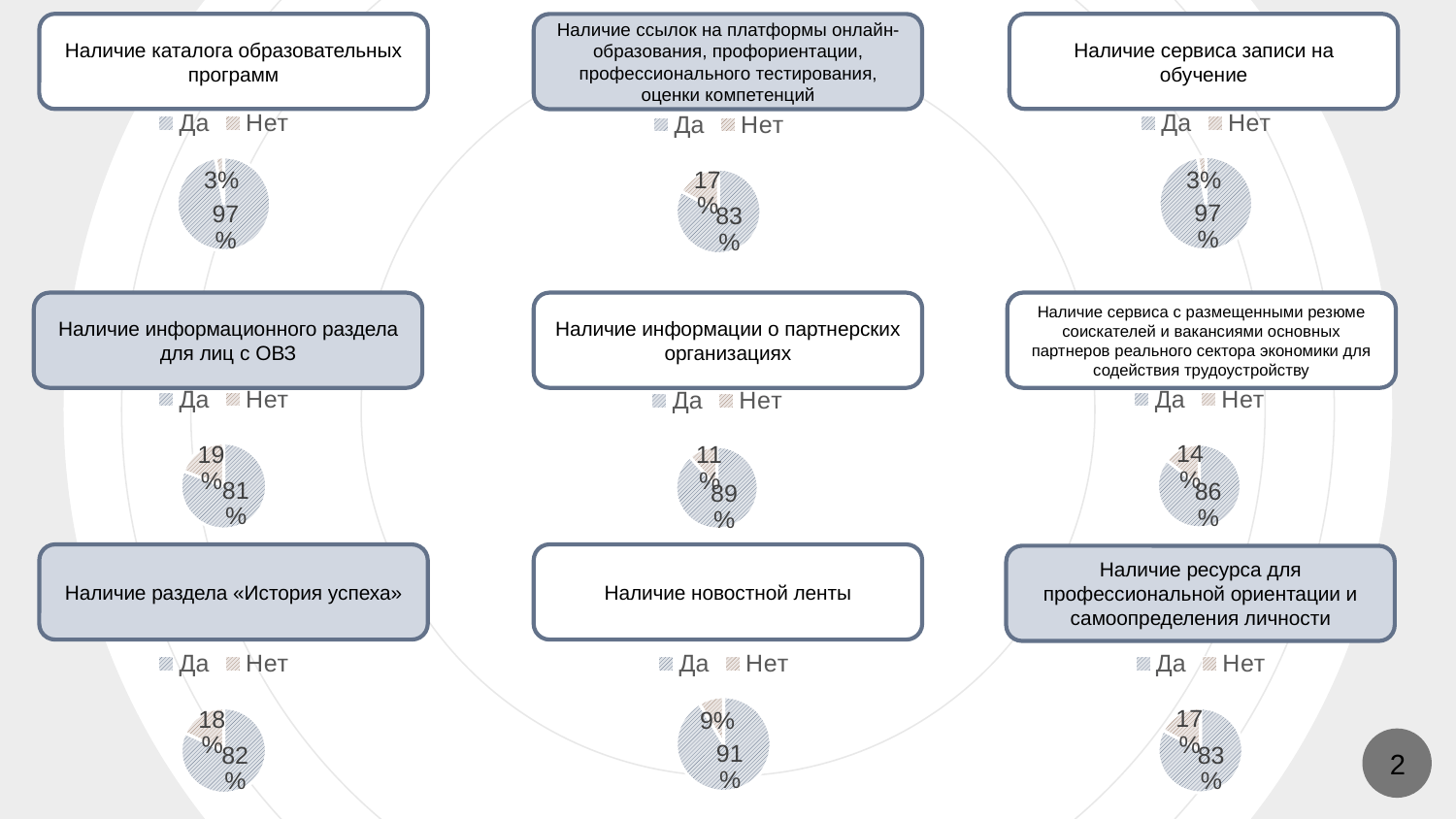
In the pie chart titled «Наличие раздела «История успеха»», what is the difference between the «Да» and «Нет» shares? 64% What type of chart is used under the title «Наличие ресурса для профессиональной ориентации и самоопределения личности»? Pie chart In the pie chart titled «Наличие каталога образовательных программ», what share is labelled for «Нет»? 3% What are the two legend entries shown above each pie chart? Да, Нет In the pie chart titled «Наличие сервиса записи на обучение», which slice is larger, «Да» or «Нет»? Да How many entries does the legend of the pie chart titled «Наличие новостной ленты» list? 2 Which pie chart on the slide has the largest «Нет» share? Наличие информационного раздела для лиц с ОВЗ In the pie chart titled «Наличие каталога образовательных программ», what share is labelled for «Да»? 97% In the pie chart titled «Наличие информационного раздела для лиц с ОВЗ», what share is labelled for «Нет»? 19% In the pie chart titled «Наличие новостной ленты», what share is labelled for «Да»? 91% How many pie charts are shown on the slide? 9 In the pie chart titled «Наличие информации о партнерских организациях», what share is labelled for «Нет»? 11%